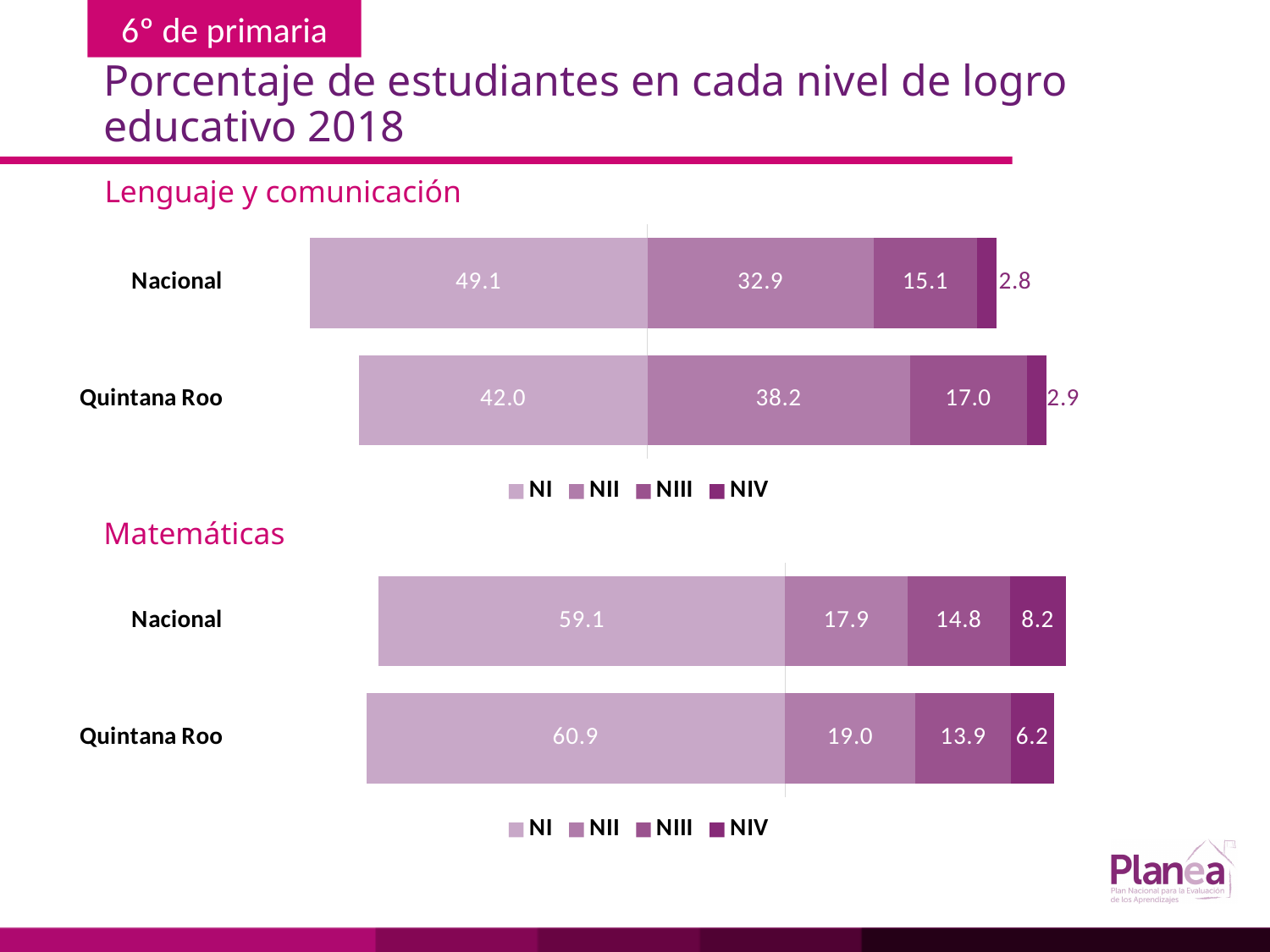
In the Lenguaje y comunicación chart, what is the NIII value for Nacional? 15.1 In the Matemáticas chart, what is the NII value for Nacional? 17.9 In the Matemáticas chart, what is the NIV value for Quintana Roo? 6.2 In the Lenguaje y comunicación chart, what is the difference between the NI values for Nacional and Quintana Roo? 7.1 In the Lenguaje y comunicación chart, what is the NI value for Quintana Roo? 42.0 How many categories are shown in the Matemáticas chart? 2 What kind of chart is the Lenguaje y comunicación chart? Stacked bar chart In the Matemáticas chart, what is the total of the Nacional stacked bar? 100.0 How many series does the legend of the Lenguaje y comunicación chart list? 4 In the Matemáticas chart, which is larger, the NI value for Nacional or for Quintana Roo? Quintana Roo In the Matemáticas chart, which level has the lowest value for Quintana Roo? NIV In the Lenguaje y comunicación chart, which level has the highest value for Nacional? NI